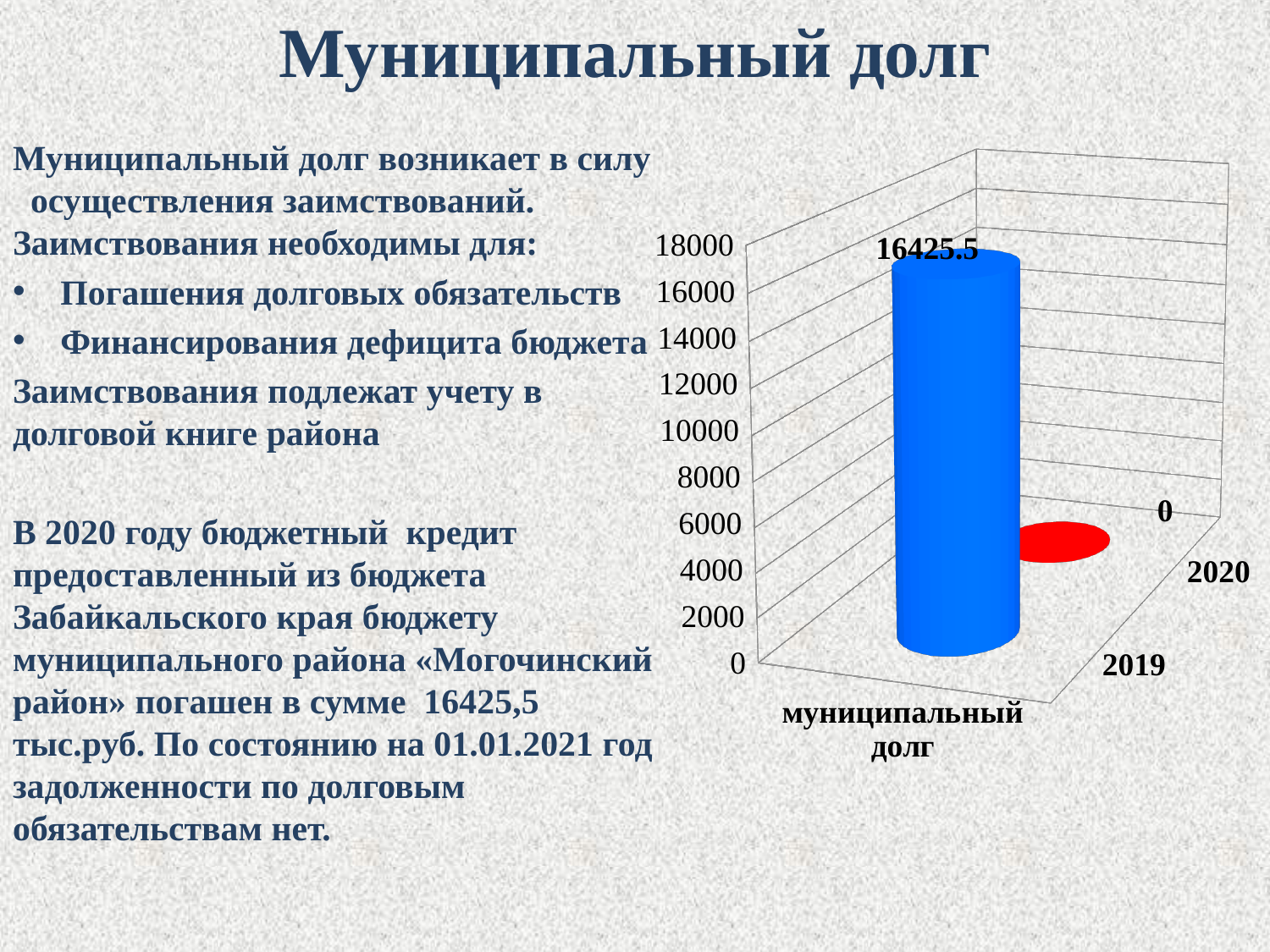
Is the value for 2019 greater or less than 16000? greater What is the difference between the 2019 and 2020 values of муниципальный долг? 16425.5 What kind of chart is shown on the slide? bar chart Is the 2019 value of муниципальный долг larger or smaller than the 2020 value? larger How many years (series) are plotted on the chart? 2 How many categories are shown on the chart's horizontal axis? 1 What colour is the bar for 2019? blue Does the value of муниципальный долг rise or fall from 2019 to 2020? fall Which year has the higher value of муниципальный долг? 2019 What is the value of муниципальный долг for 2020? 0 Which year has the lowest value of муниципальный долг? 2020 What is the value of муниципальный долг for 2019? 16425.5